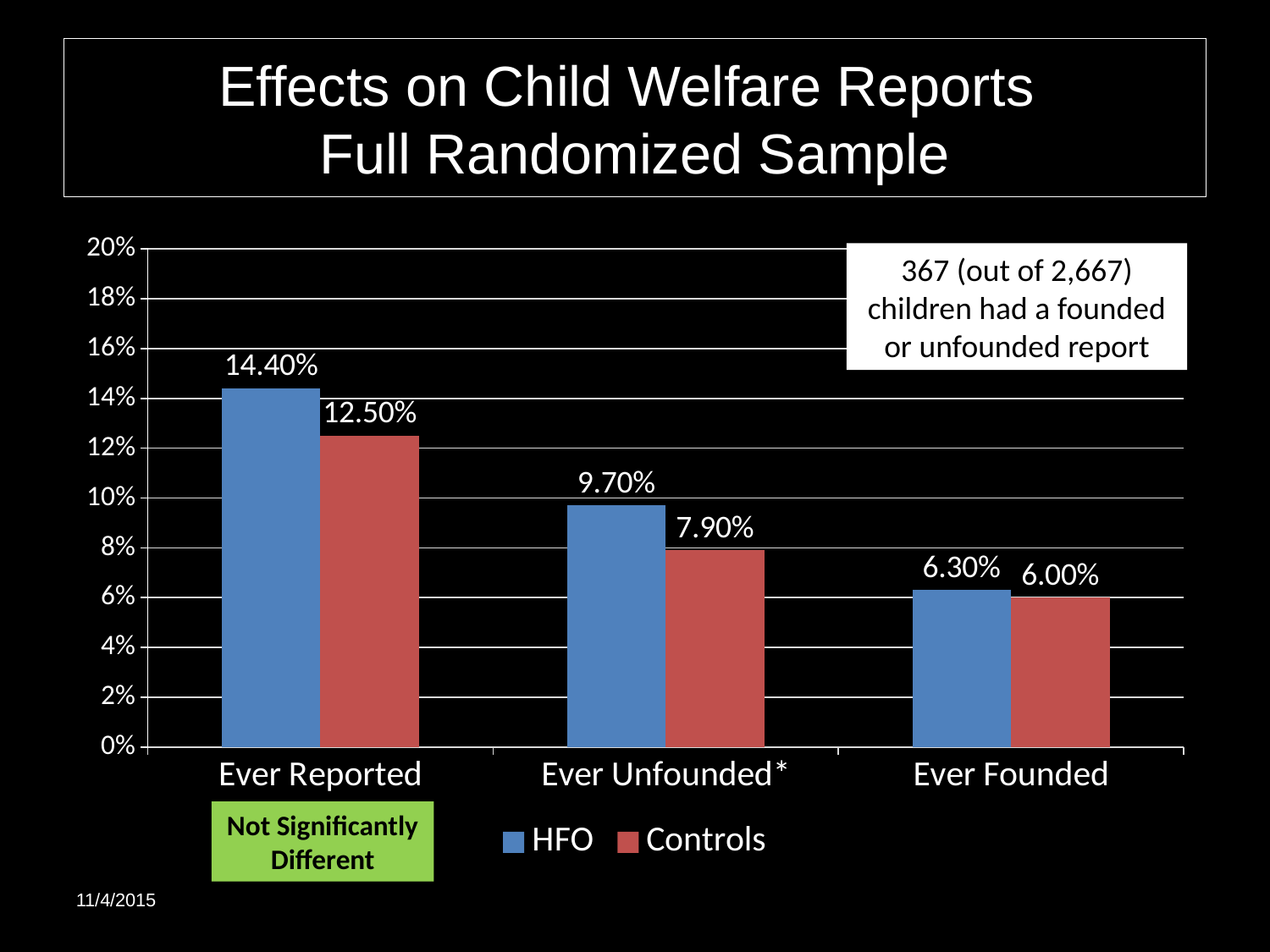
What is the Controls value for Ever Unfounded*? 7.90% What is the difference between the HFO and Controls values for Ever Reported? 1.90% Which is larger for Ever Unfounded*, the HFO value or the Controls value? HFO Which category has the highest HFO value? Ever Reported Do the HFO values rise or fall from Ever Reported to Ever Founded? Fall Which category has the lowest Controls value? Ever Founded What is the HFO value for Ever Reported? 14.40% What kind of chart is shown on the slide? Bar chart What is the Controls value for Ever Founded? 6.00% How many series does the legend list? 2 What is the difference between the HFO and Controls values for Ever Unfounded*? 1.80% How many categories are shown on the x axis? 3